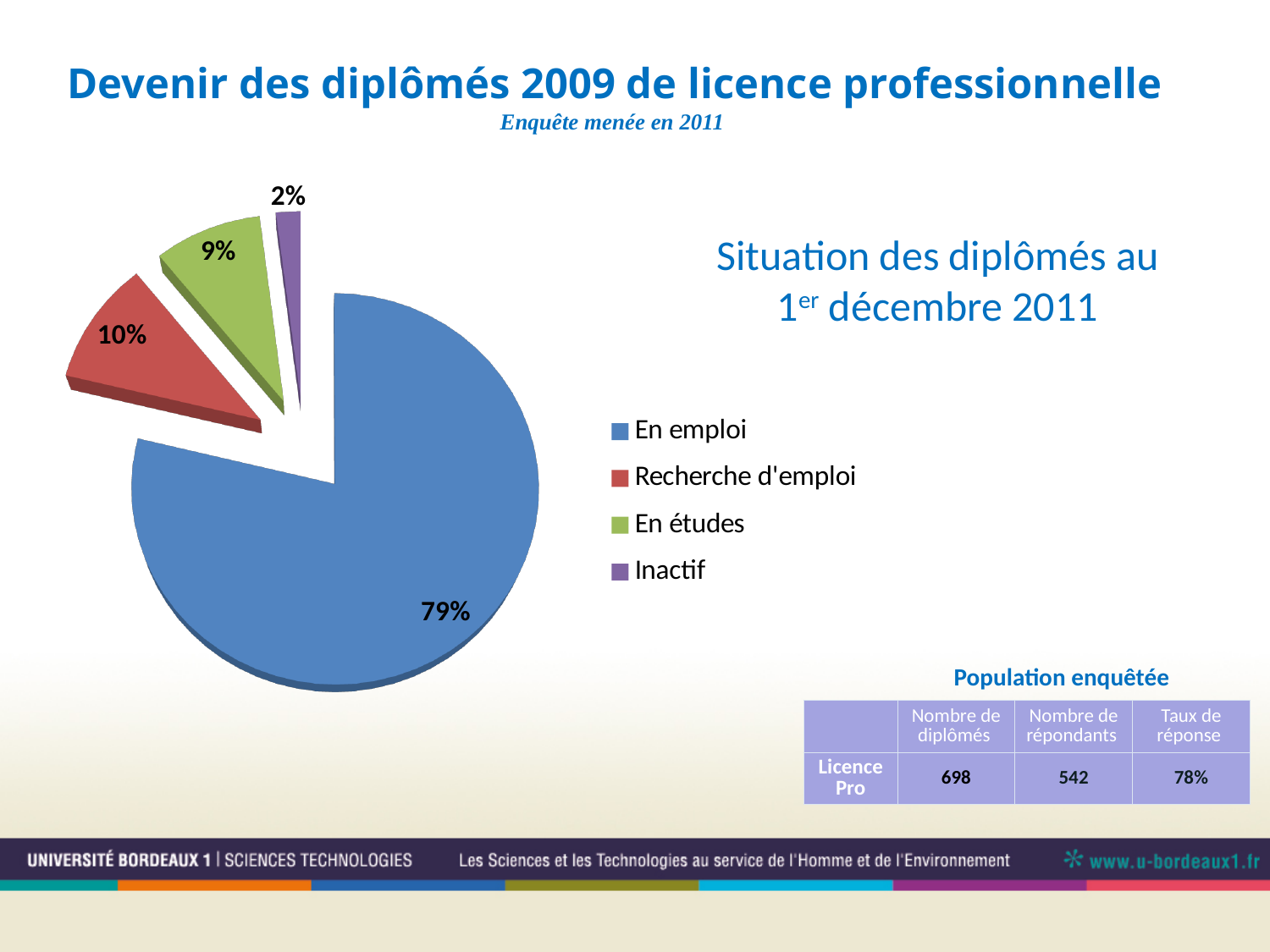
What share of the pie does Inactif represent? 2% Which category has the smallest slice of the pie? Inactif Which is larger, the share for En études or the share for Inactif? En études How many categories does the pie chart show? 4 What colour is the slice for Recherche d'emploi? Red What share of the pie does En études represent? 9% What share of the pie does En emploi represent? 79% Which category has the largest slice of the pie? En emploi What is the difference in percentage points between En emploi and Recherche d'emploi? 69 What kind of chart is shown on the slide? Pie chart What is the difference in percentage points between Recherche d'emploi and En études? 1